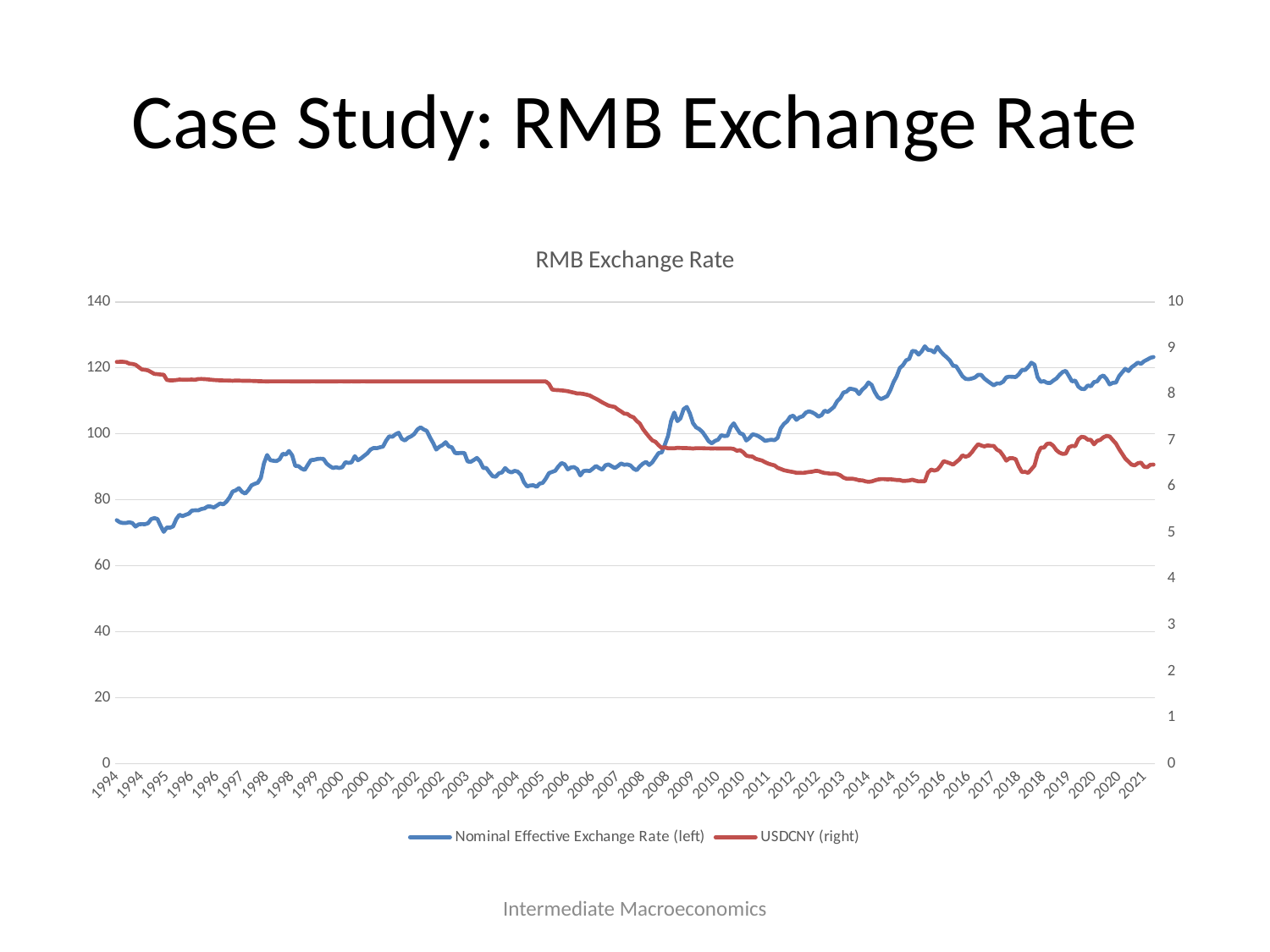
Is the value of the Nominal Effective Exchange Rate at the start of 1994 greater or less than 80? less What kind of chart is shown on the slide? line chart Is the value of the Nominal Effective Exchange Rate at its 2015 peak greater or less than 120? greater Does the Nominal Effective Exchange Rate overall rise or fall from 1994 to 2021? rise Does USDCNY rise or fall from 2005 to 2014? fall Is the value of USDCNY in 2014 greater or less than 7? less Which is larger for the Nominal Effective Exchange Rate: the value in 1994 or the value in 2015? 2015 Which series is plotted against the right axis according to the legend? USDCNY (right) How many series does the legend list? 2 What is the title of the chart? RMB Exchange Rate